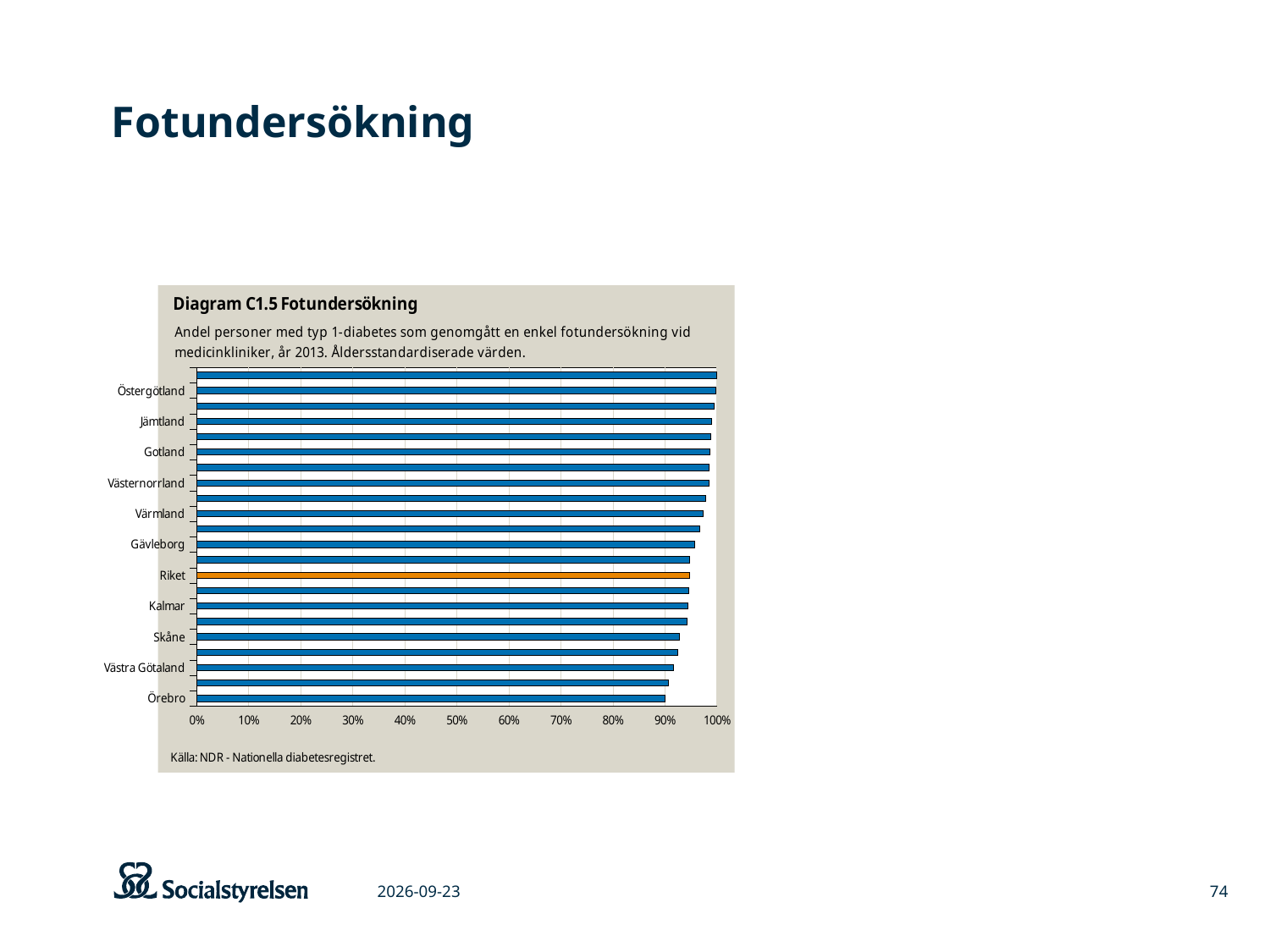
Is the value for Riket greater or less than 90%? greater What is the title of the chart? Diagram C1.5 Fotundersökning Is the value for Örebro greater or less than 80%? greater Is the value for Västra Götaland greater or less than 100%? less Which has the larger value, Jämtland or Skåne? Jämtland Do the bar values rise or fall going from the top of the chart to the bottom? fall Which category is drawn in a different colour (orange) from the other bars? Riket What kind of chart is shown in Diagram C1.5 Fotundersökning? bar chart Which labelled region has the lowest share in Diagram C1.5 Fotundersökning? Örebro Which has the larger value, Östergötland or Örebro? Östergötland